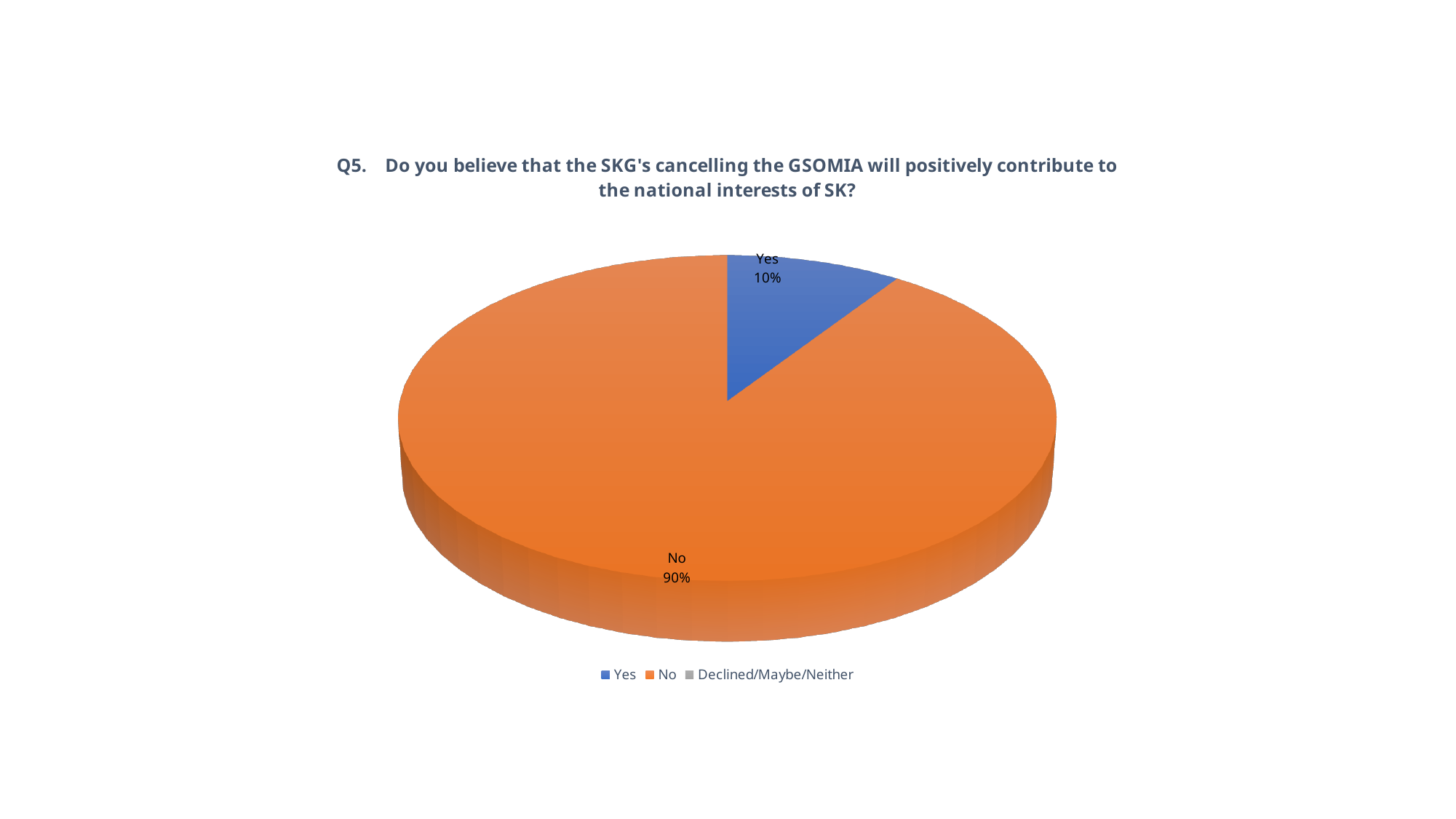
Is the Yes slice larger or smaller than the No slice? smaller How many slices have a visible data label on the pie? 2 How many entries does the legend list? 3 What share of the pie is labelled "No"? 90% What is the question number shown at the start of the chart title? Q5 Which of the two labelled slices, Yes or No, is smaller? Yes What share of the pie is labelled "Yes"? 10% What is the third entry in the legend, after Yes and No? Declined/Maybe/Neither What is the difference in percentage points between the No and Yes slices? 80 percentage points What colour is the No slice? orange Which response has the largest slice of the pie? No What kind of chart is shown on the slide? pie chart